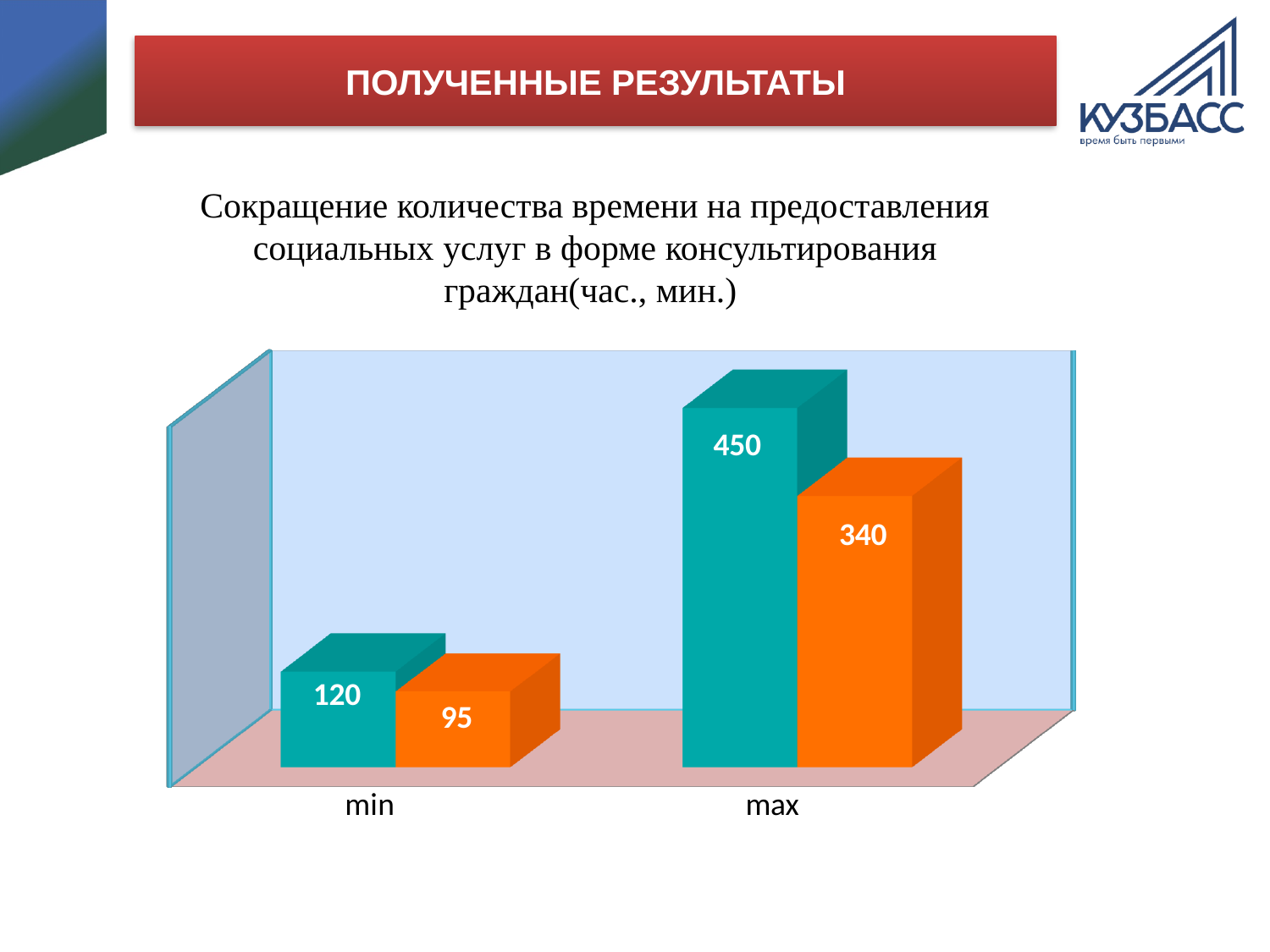
What is the difference between the teal and orange bars in the "min" category? 25 What is the value of the teal bar for the "min" category? 120 What is the difference between the teal and orange bars in the "max" category? 110 What type of chart is shown on the slide? Bar chart In the "max" category, which bar is larger, the teal one or the orange one? The teal one What is the value of the teal bar for the "max" category? 450 Which bar on the chart has the lowest value? The orange bar for min (95) What are the two category labels on the x axis of the chart? min and max Which bar on the chart has the highest value? The teal bar for max (450) What is the value of the orange bar for the "min" category? 95 What is the value of the orange bar for the "max" category? 340 How many categories are shown on the x axis of the chart? 2